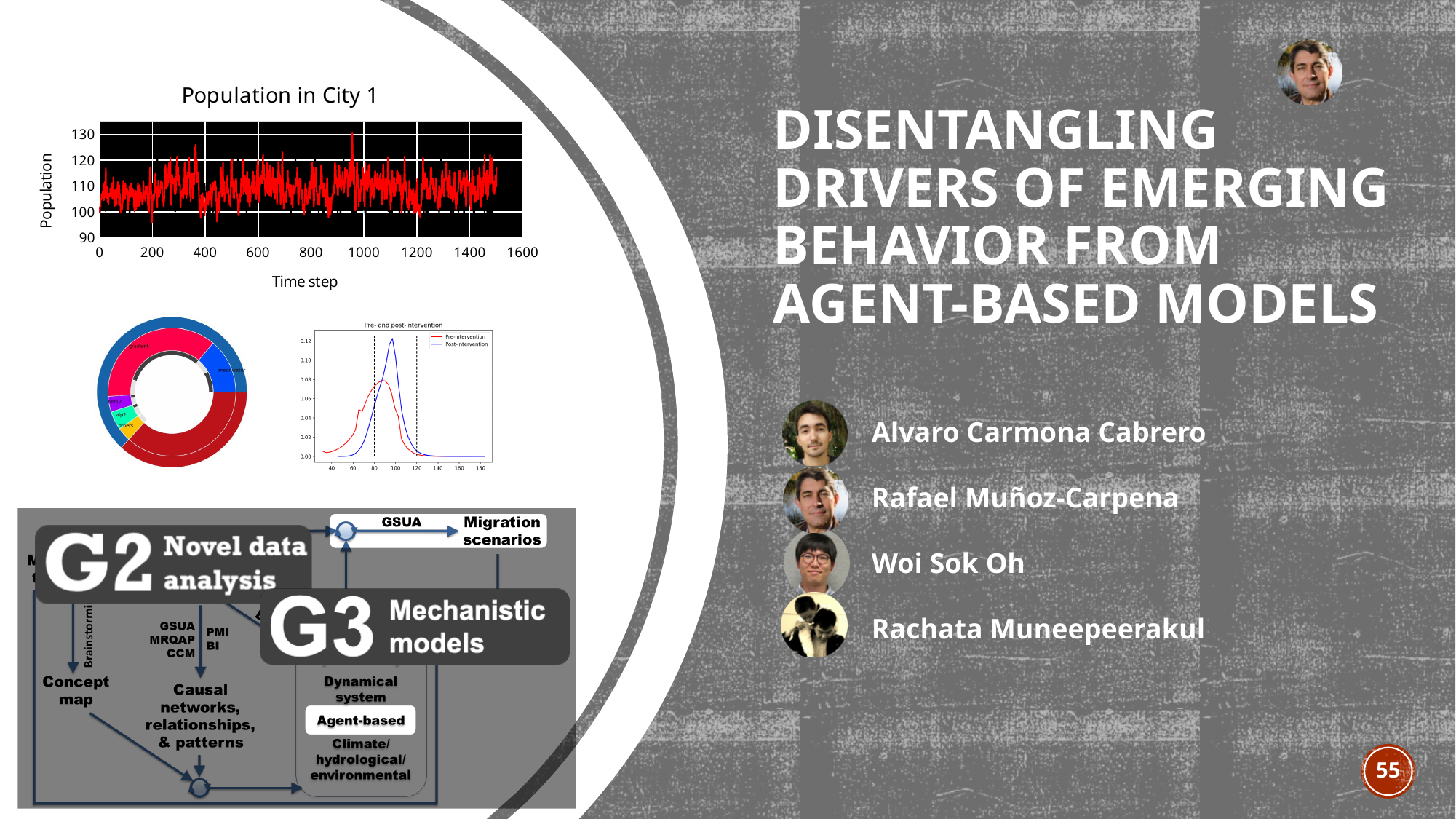
In the 'Pre- and post-intervention' chart, what colour is the Pre-intervention line? red In the 'Population in City 1' chart, what is the label of the x axis? Time step In the 'Population in City 1' chart, what is the highest tick value shown on the y axis? 130 In the 'Pre- and post-intervention' chart, which series reaches the higher peak, Pre-intervention or Post-intervention? Post-intervention What is the title of the chart at the top left of the slide? Population in City 1 In the 'Population in City 1' chart, what is the largest tick value shown on the x axis? 1600 What kind of chart is the 'Population in City 1' chart? line chart In the 'Population in City 1' chart, is the population at time step 0 greater or less than 120? less What kind of chart is the ring-shaped chart in the middle left of the slide? donut (pie) chart In the 'Pre- and post-intervention' chart, is the peak of the Post-intervention curve greater or less than 0.10? greater In the 'Pre- and post-intervention' chart, is the peak of the Pre-intervention curve greater or less than 0.10? less In the 'Pre- and post-intervention' chart, how many series does the legend list? 2